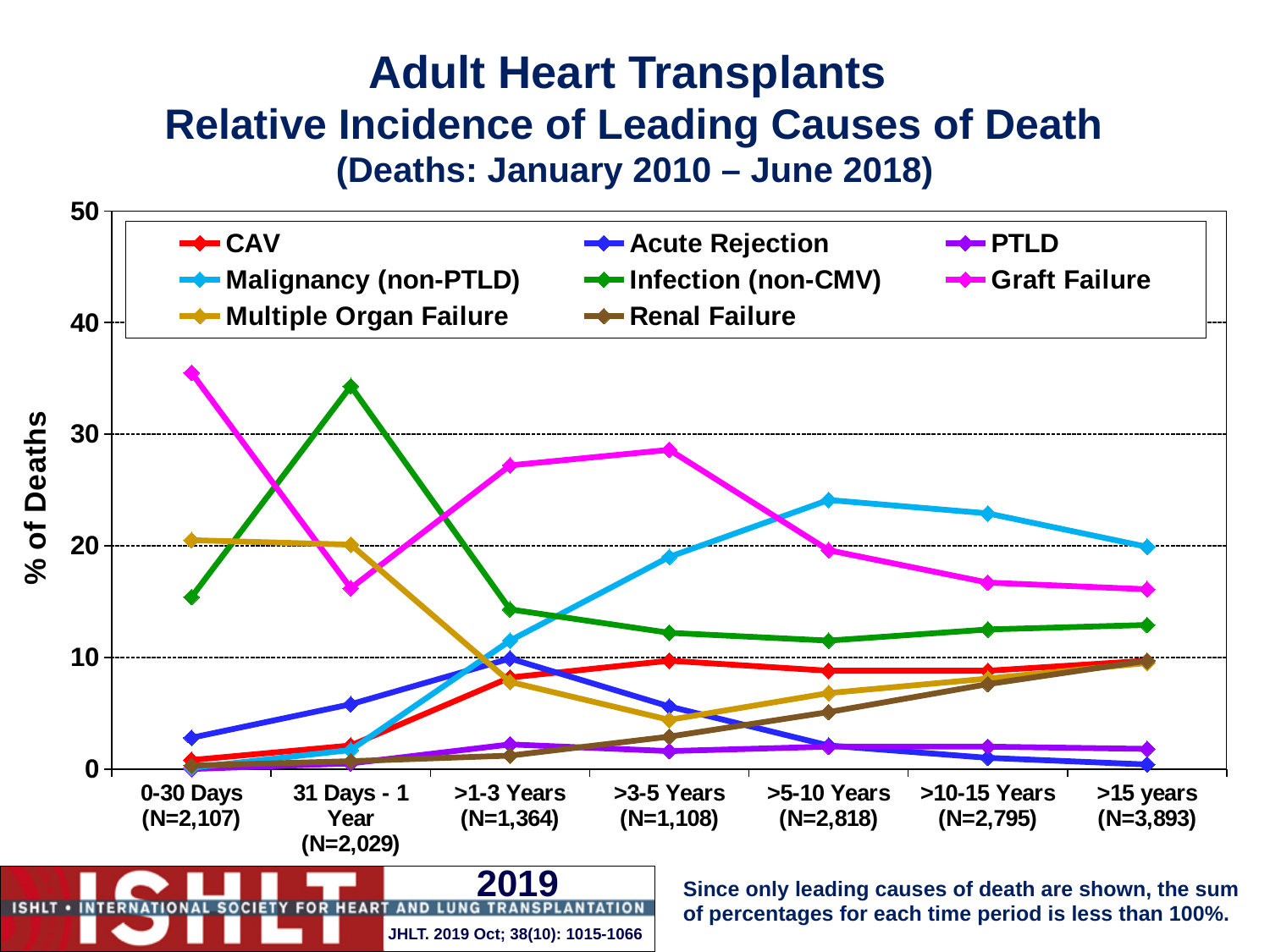
What is the label of the y axis? % of Deaths Does the Acute Rejection line rise or fall from >1-3 Years to >15 years? Falls Is the value for Malignancy (non-PTLD) in the >5-10 Years period greater or less than 20? greater Which cause of death has the highest percentage in the >5-10 Years period? Malignancy (non-PTLD) In the >3-5 Years period, which is larger: Graft Failure or Malignancy (non-PTLD)? Graft Failure How many causes of death does the legend list? 8 Which cause of death has the highest percentage in the 31 Days - 1 Year period? Infection (non-CMV) Is the value for Graft Failure in the 0-30 Days period greater or less than 30? greater How many time periods are shown along the x axis? 7 Does the Renal Failure line rise or fall across the time periods from 0-30 Days to >15 years? Rises Which cause of death has the highest percentage in the 0-30 Days period? Graft Failure What type of chart is shown on the slide? Line chart